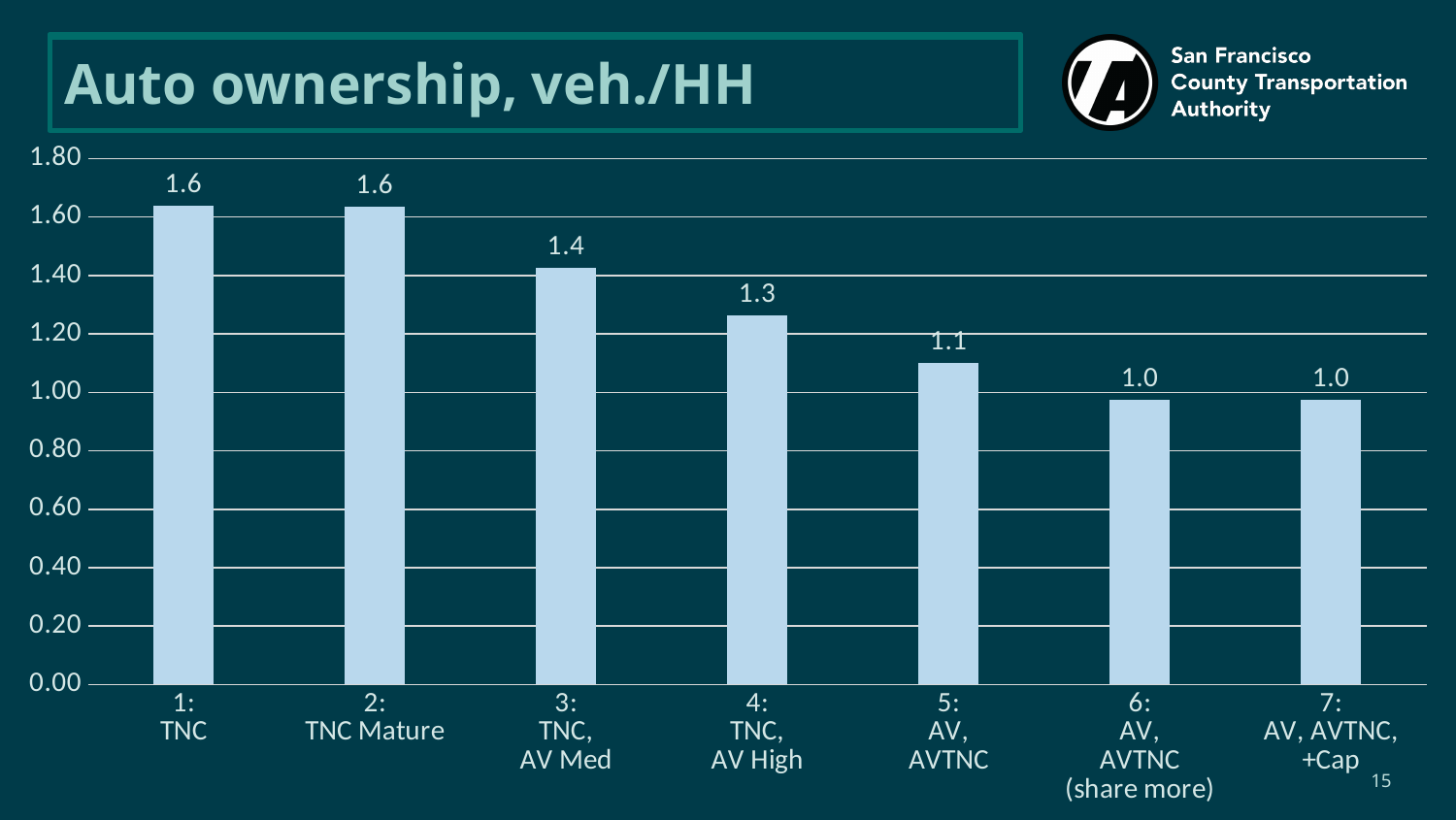
How many scenarios are plotted on the chart? 7 Is the value for scenario 4: TNC, AV High greater or less than 1.20? greater What is the value shown for scenario 7: AV, AVTNC, +Cap? 1.0 Do the values rise or fall moving from scenario 1 to scenario 7 along the x axis? fall What is the auto ownership value for scenario 1: TNC? 1.6 What kind of chart is shown on the slide? bar chart What is the value shown for scenario 3: TNC, AV Med? 1.4 What is the value shown for scenario 5: AV, AVTNC? 1.1 What is the lowest value plotted on the chart? 1.0 What is the highest value plotted on the chart? 1.6 What is the difference between the values for scenario 1: TNC and scenario 4: TNC, AV High? 0.3 Which has a larger value, scenario 3: TNC, AV Med or scenario 5: AV, AVTNC? 3: TNC, AV Med